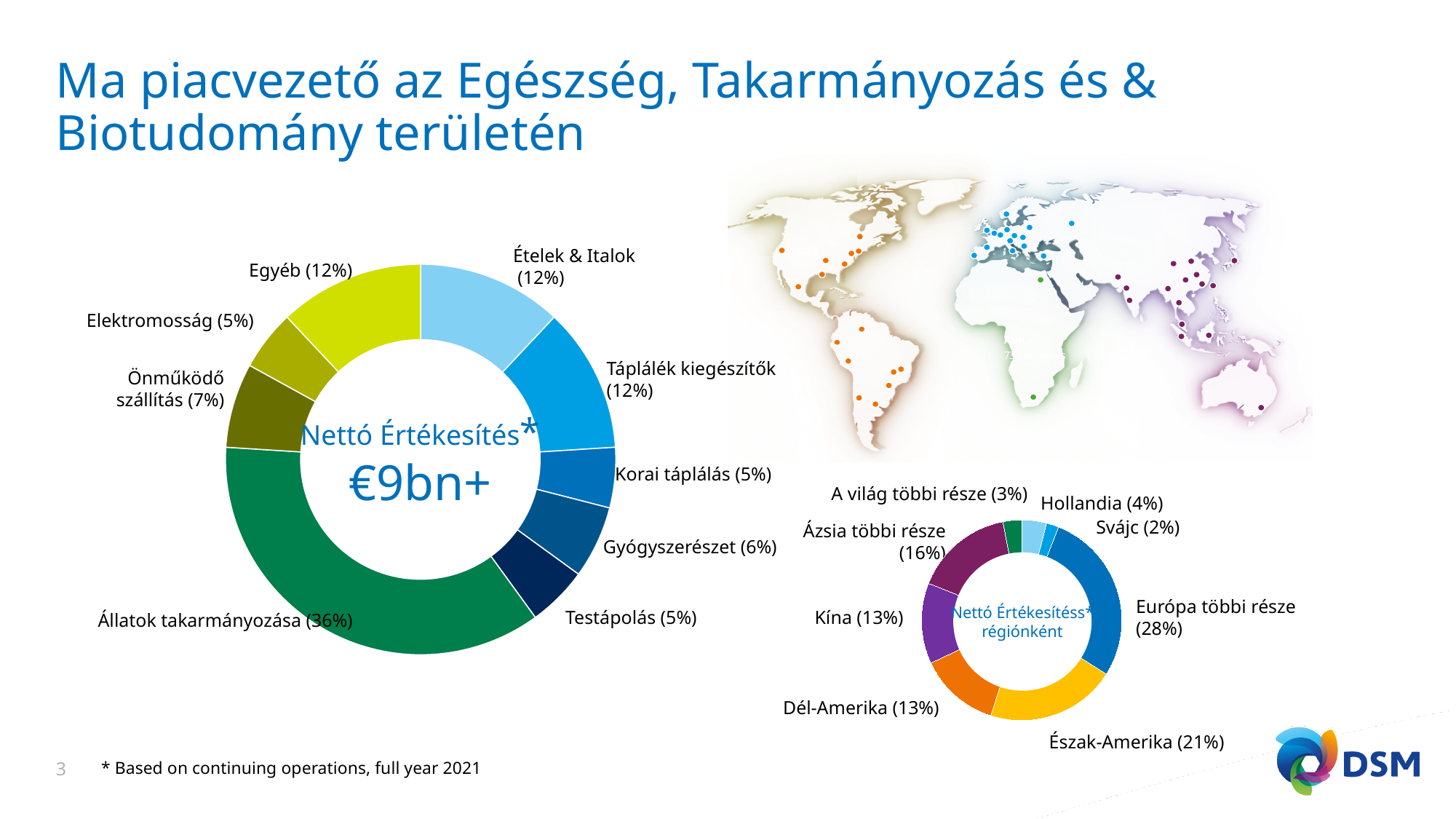
In the left donut chart (Nettó Értékesítés), what share does Gyógyszerészet have? 6% In the right donut chart (Nettó Értékesítés régiónként), how many regions are shown? 8 In the left donut chart (Nettó Értékesítés), what is the difference in percentage points between Állatok takarmányozása and Egyéb? 24 What type of chart is used for the Nettó Értékesítés régiónként breakdown on the right? Donut (pie) chart In the left donut chart (Nettó Értékesítés), how many categories are shown? 9 In the right donut chart (Nettó Értékesítés régiónként), what is the difference in percentage points between Észak-Amerika and Dél-Amerika? 8 In the right donut chart (Nettó Értékesítés régiónként), what share does Európa többi része have? 28% What total net sales figure is printed in the centre of the left donut chart? €9bn+ In the left donut chart (Nettó Értékesítés), what share does Állatok takarmányozása have? 36% In the left donut chart (Nettó Értékesítés), which category has the largest share? Állatok takarmányozása In the right donut chart (Nettó Értékesítés régiónként), which region has the smallest share? Svájc In the left donut chart (Nettó Értékesítés), which is larger: Önműködő szállítás or Elektromosság? Önműködő szállítás